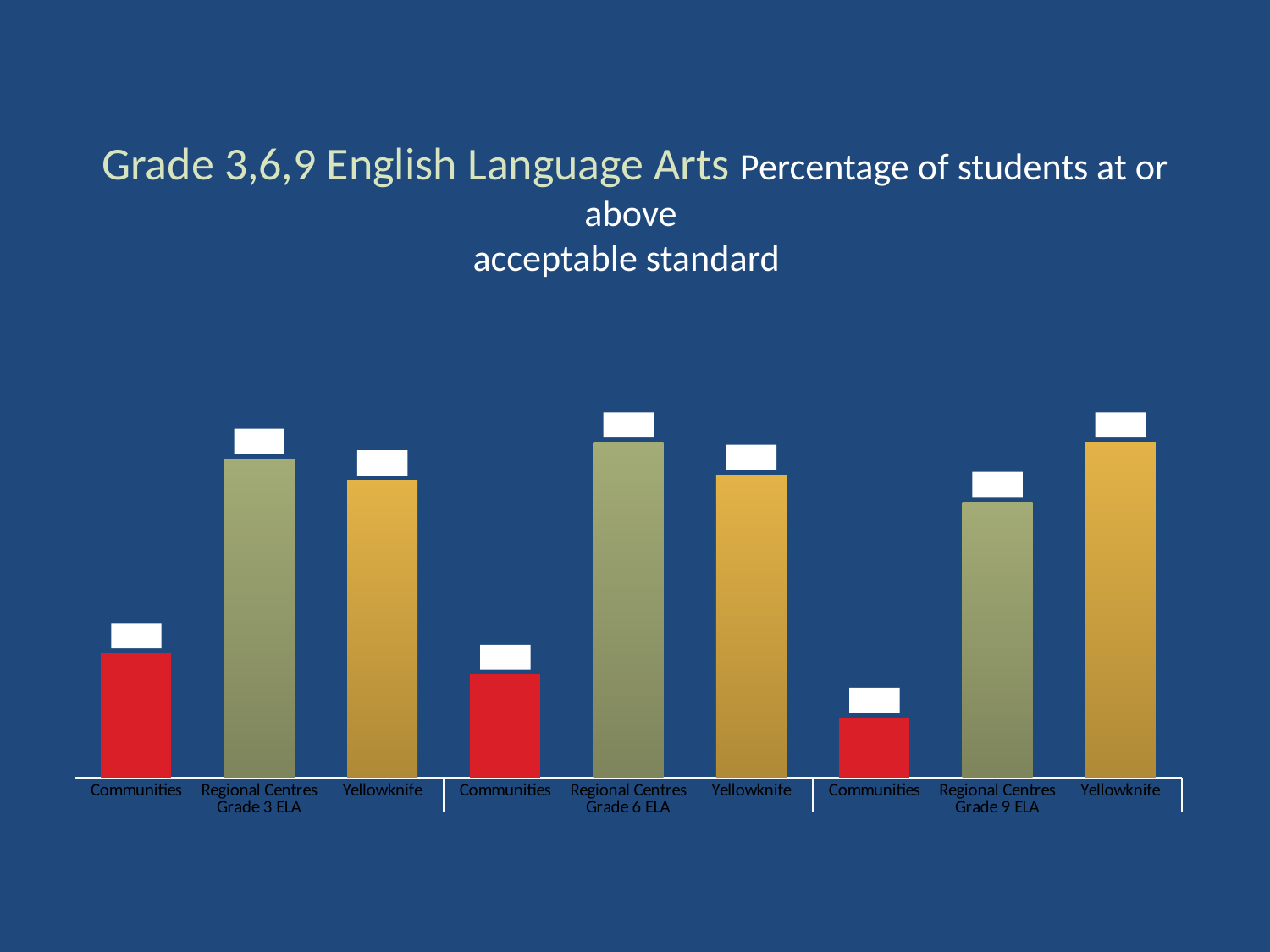
Within the Grade 3 ELA group, which category has the lowest bar? Communities Within the Grade 3 ELA group, which category has the highest bar? Regional Centres Is the Communities bar for Grade 3 ELA or for Grade 9 ELA taller? Grade 3 ELA How many grade groups (Grade 3 ELA, Grade 6 ELA, Grade 9 ELA) are shown along the x axis? 3 What subject does the chart title say the percentages refer to? English Language Arts What kind of chart is shown on the slide? bar chart In the Grade 9 ELA group, is the bar for Regional Centres or Yellowknife taller? Yellowknife Within the Grade 6 ELA group, which category has the highest bar? Regional Centres Within the Grade 9 ELA group, which category has the highest bar? Yellowknife How many bars are plotted in the chart? 9 Which bar is the lowest in the entire chart? Communities, Grade 9 ELA What colour are the Communities bars in the chart? red